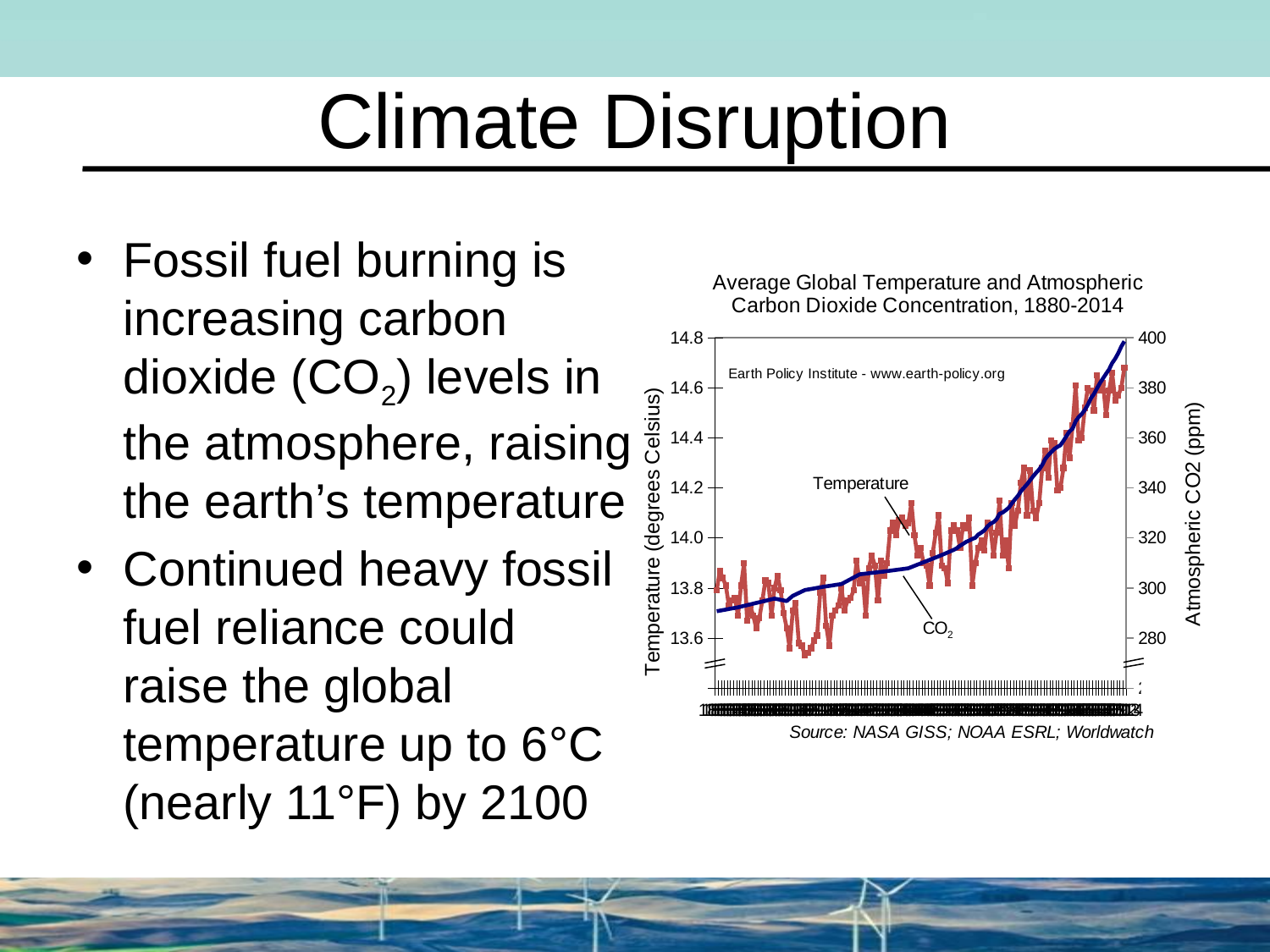
At which end of the chart, left or right, does the CO2 line reach its highest value? Right end Is the CO2 value at the right end of the chart (2014) greater or less than 380 ppm? greater Is the CO2 value at the left end of the chart (1880) greater or less than 300 ppm? less At which end of the chart, left or right, is the CO2 line at its lowest value? Left end What is the title of the chart? Average Global Temperature and Atmospheric Carbon Dioxide Concentration, 1880-2014 Does the CO2 line rise or fall from left to right across the chart? Rise Which series is drawn as the smooth dark blue line? CO2 Overall, does the Temperature line rise or fall from 1880 to 2014? Rise Is the lowest Temperature value on the chart greater or less than 13.8 degrees Celsius? less How many data series are plotted on the chart? 2 What kind of chart is shown on the slide? Line chart